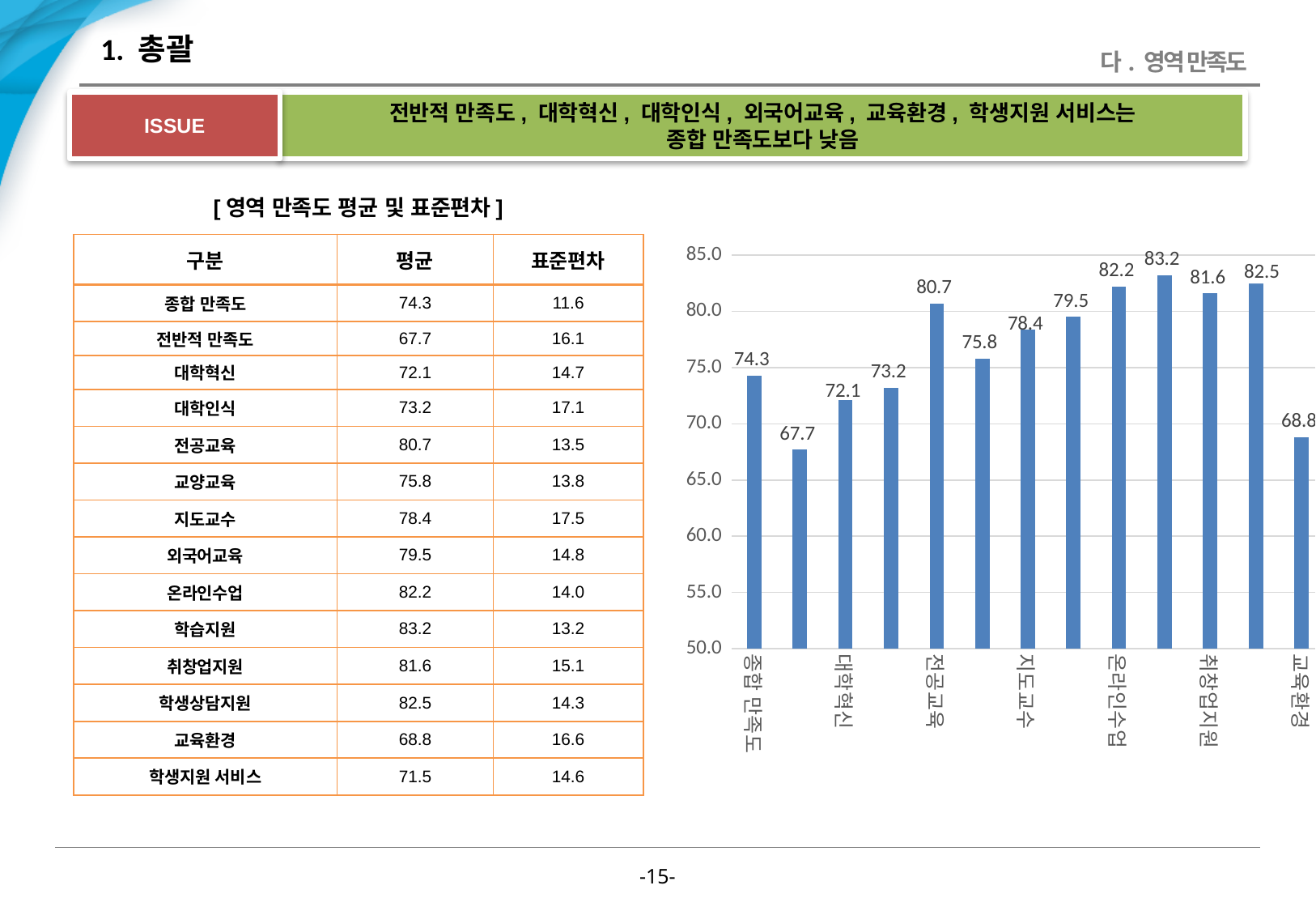
What is the value of the bar for 전공교육 in the chart? 80.7 Which has a higher value in the chart, 지도교수 or 대학혁신? 지도교수 What is the value of the bar for 교육환경 in the chart? 68.8 What is the value of the bar for 온라인수업 in the chart? 82.2 What is the difference between the values for 온라인수업 and 종합 만족도 in the chart? 7.9 What type of chart is shown on the slide? bar chart What is the highest data label shown on the chart? 83.2 What is the value of the bar for 종합 만족도 in the chart? 74.3 How many bars are shown in the chart? 13 Is the value for 교육환경 in the chart greater or less than 70.0? less What is the value of the bar for 취창업지원 in the chart? 81.6 What is the lowest data label shown on the chart? 67.7